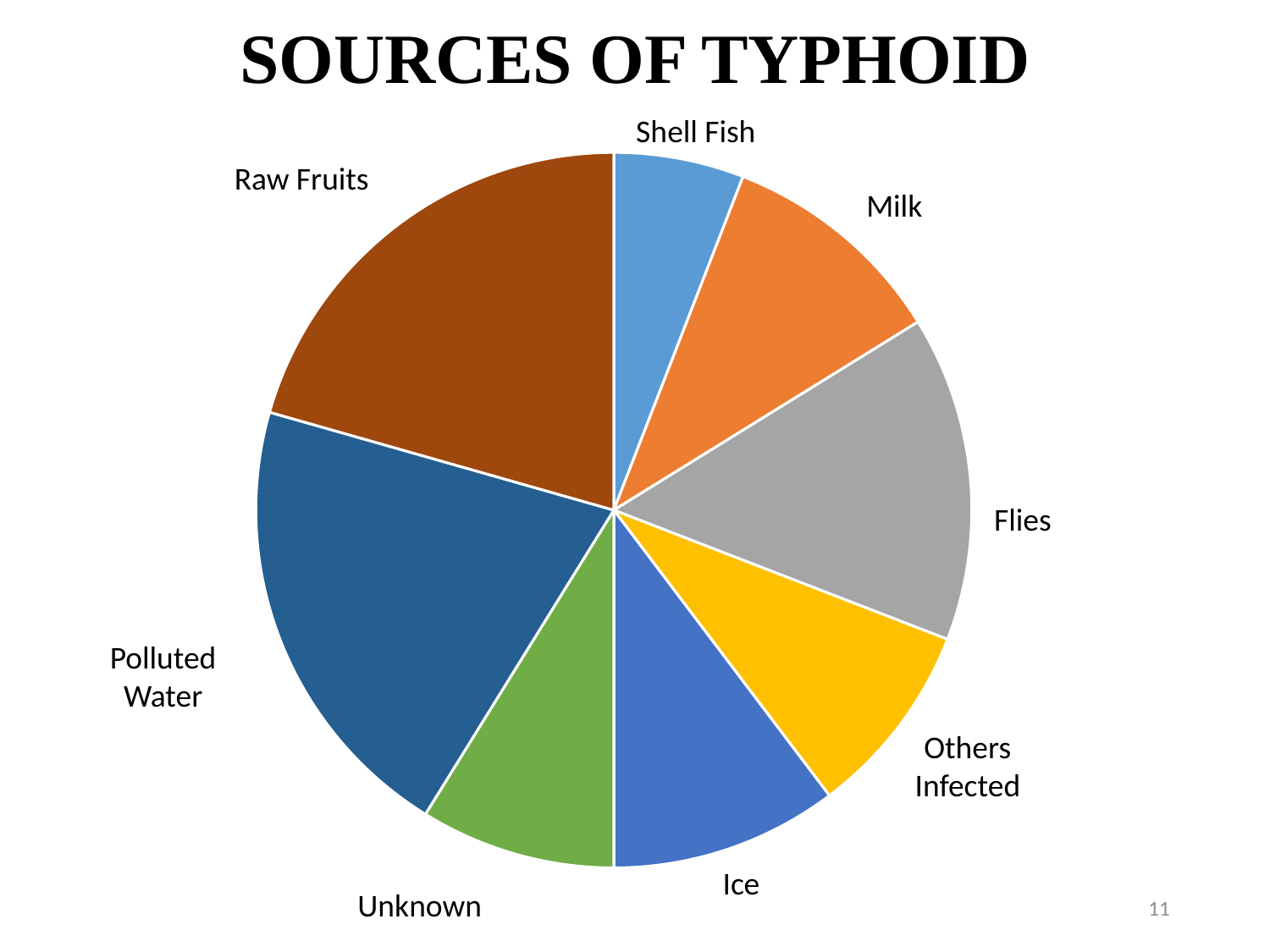
Which slice is larger, Polluted Water or Unknown? Polluted Water Which slice is larger, Raw Fruits or Ice? Raw Fruits What is the title of the chart? SOURCES OF TYPHOID Which source has the smallest slice of the pie? Shell Fish What kind of chart is shown on the slide? Pie chart Which slice is larger, Milk or Shell Fish? Milk What colour is the Flies slice? Gray How many slices does the pie chart have? 8